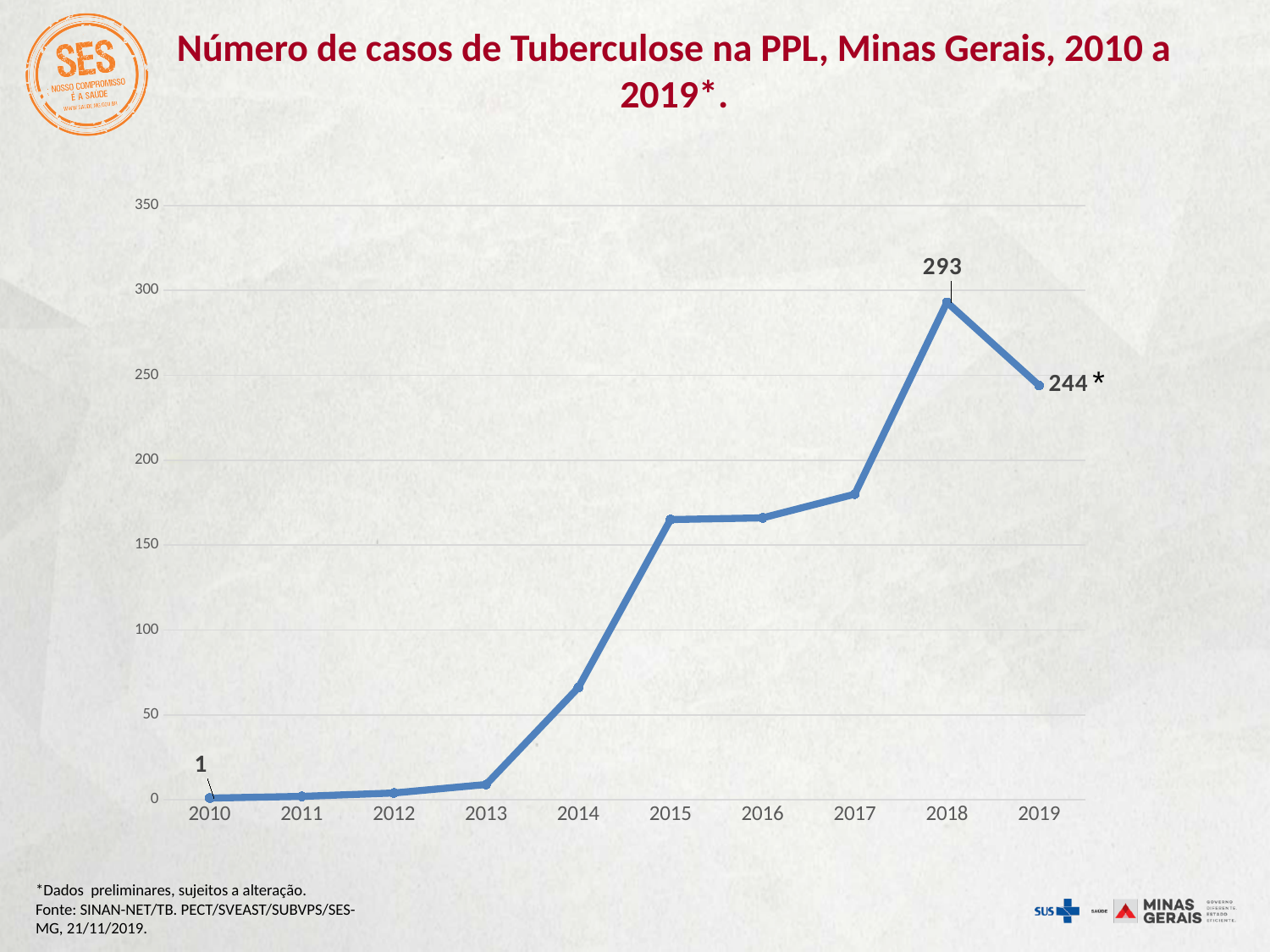
Which year has the highest number of cases? 2018 Which year has the lowest number of cases? 2010 Is the value for 2015 greater or less than 150? greater What is the number of tuberculosis cases shown for 2018? 293 How many years are plotted on the x axis? 10 Is the value for 2017 greater or less than 200? less Which year has more cases, 2018 or 2019? 2018 What kind of chart is shown on the slide? line chart Is the value for 2014 greater or less than 100? less What is the difference between the number of cases in 2018 and in 2019? 49 What is the number of cases shown for 2019? 244 What is the number of cases shown for 2010? 1